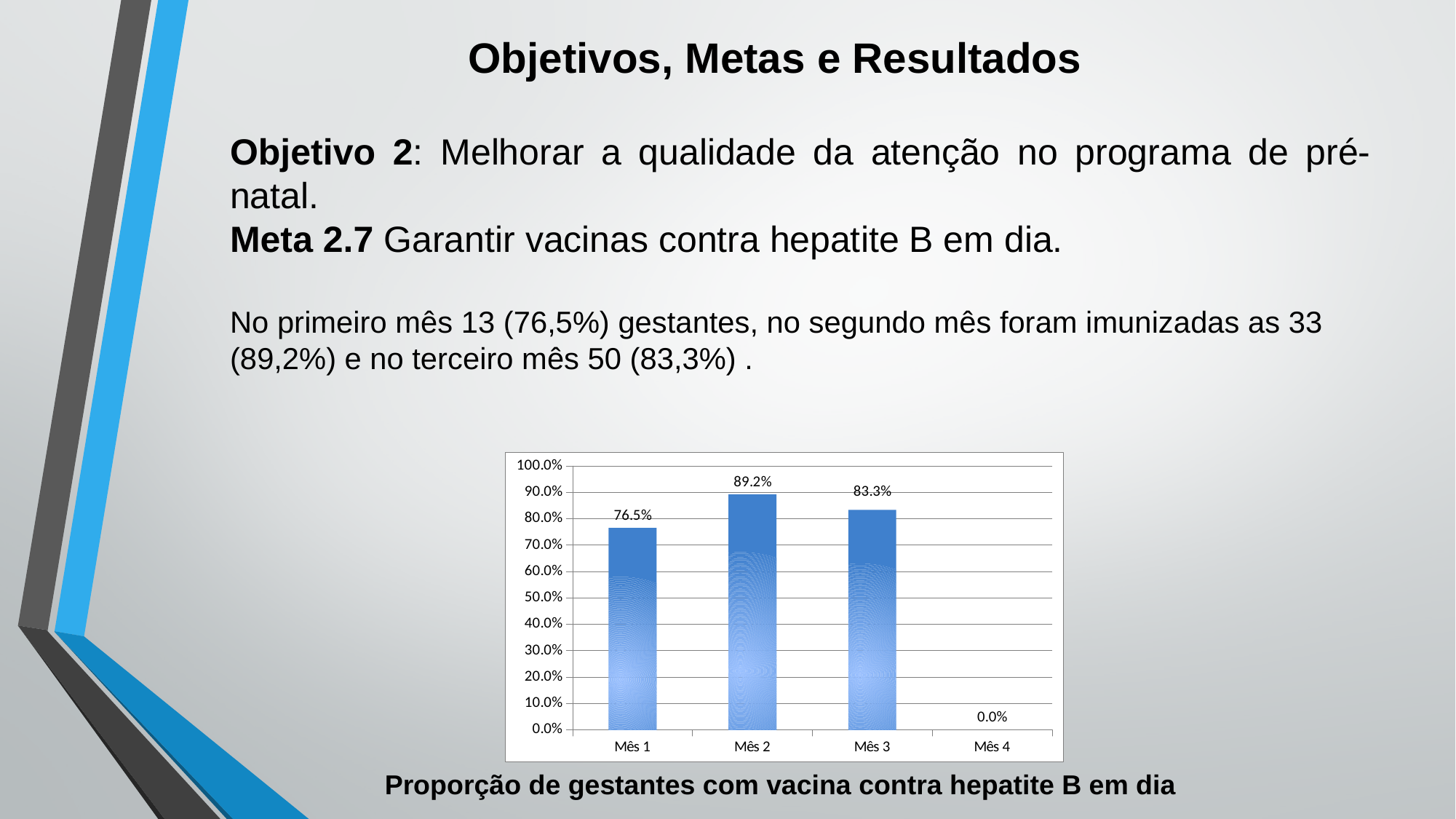
How many categories are shown on the x axis? 4 What is the value for Mês 4? 0.0% Which is larger, the value for Mês 2 or Mês 3? Mês 2 Is the value for Mês 1 greater or less than 80.0%? less Which month has the highest value? Mês 2 What is the difference between the values for Mês 2 and Mês 1? 12.7% What is the value for Mês 1? 76.5% What is the value for Mês 3? 83.3% What kind of chart is shown? bar chart What is the caption below the chart? Proporção de gestantes com vacina contra hepatite B em dia Which month has the lowest value? Mês 4 What is the value for Mês 2? 89.2%